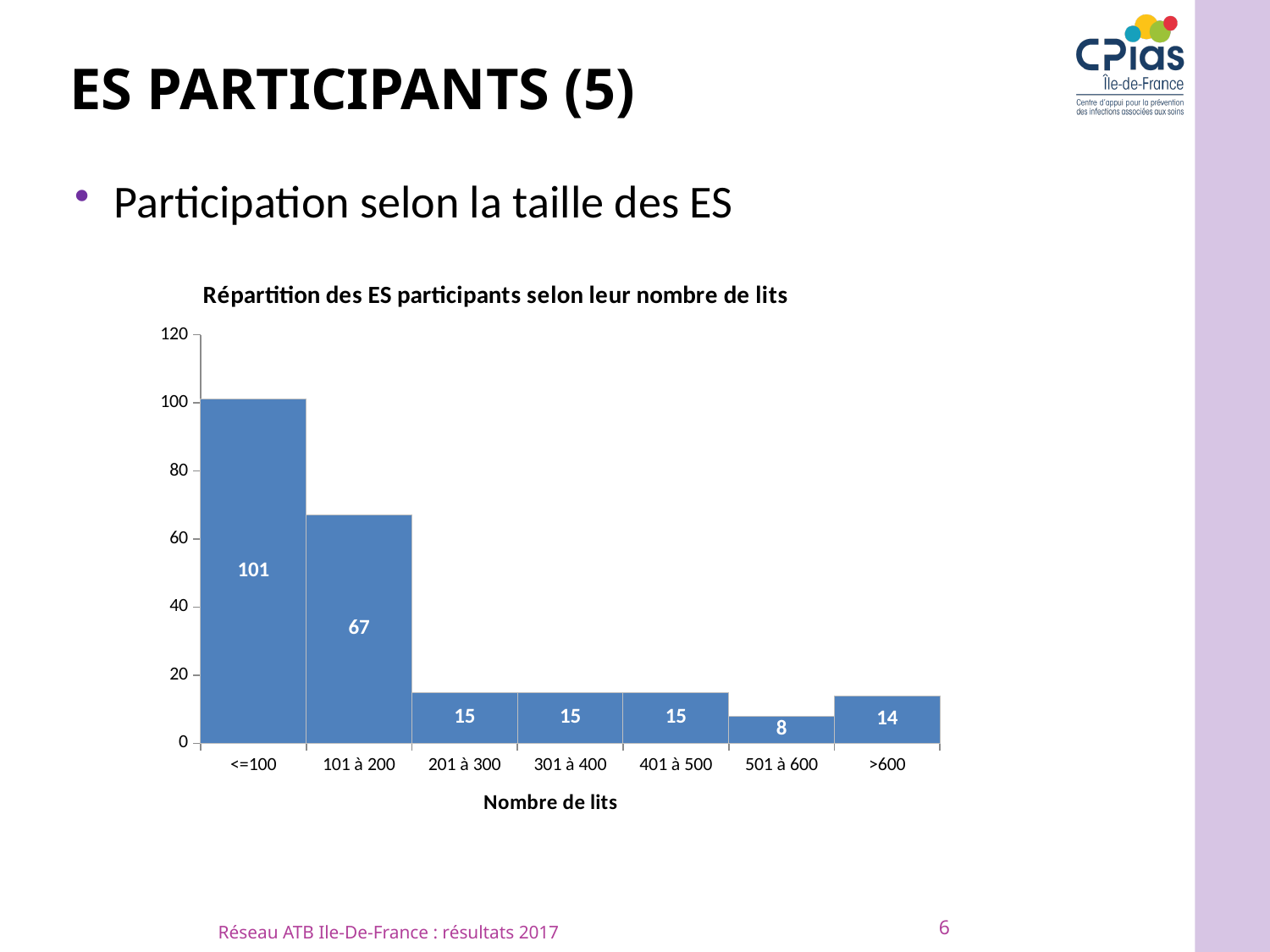
Is the value for "101 à 200" greater or less than 60? greater What is the value for the "<=100" category? 101 Which is larger, the value for "501 à 600" or the value for ">600"? >600 Which category has the lowest value? 501 à 600 What is the title of the chart? Répartition des ES participants selon leur nombre de lits What is the difference between the values for "<=100" and "101 à 200"? 34 What kind of chart is shown on the slide? Bar chart How many categories are shown on the x axis? 7 What is the value for the ">600" category? 14 Which category has the highest value? <=100 What is the value for the "501 à 600" category? 8 What is the value for the "101 à 200" category? 67